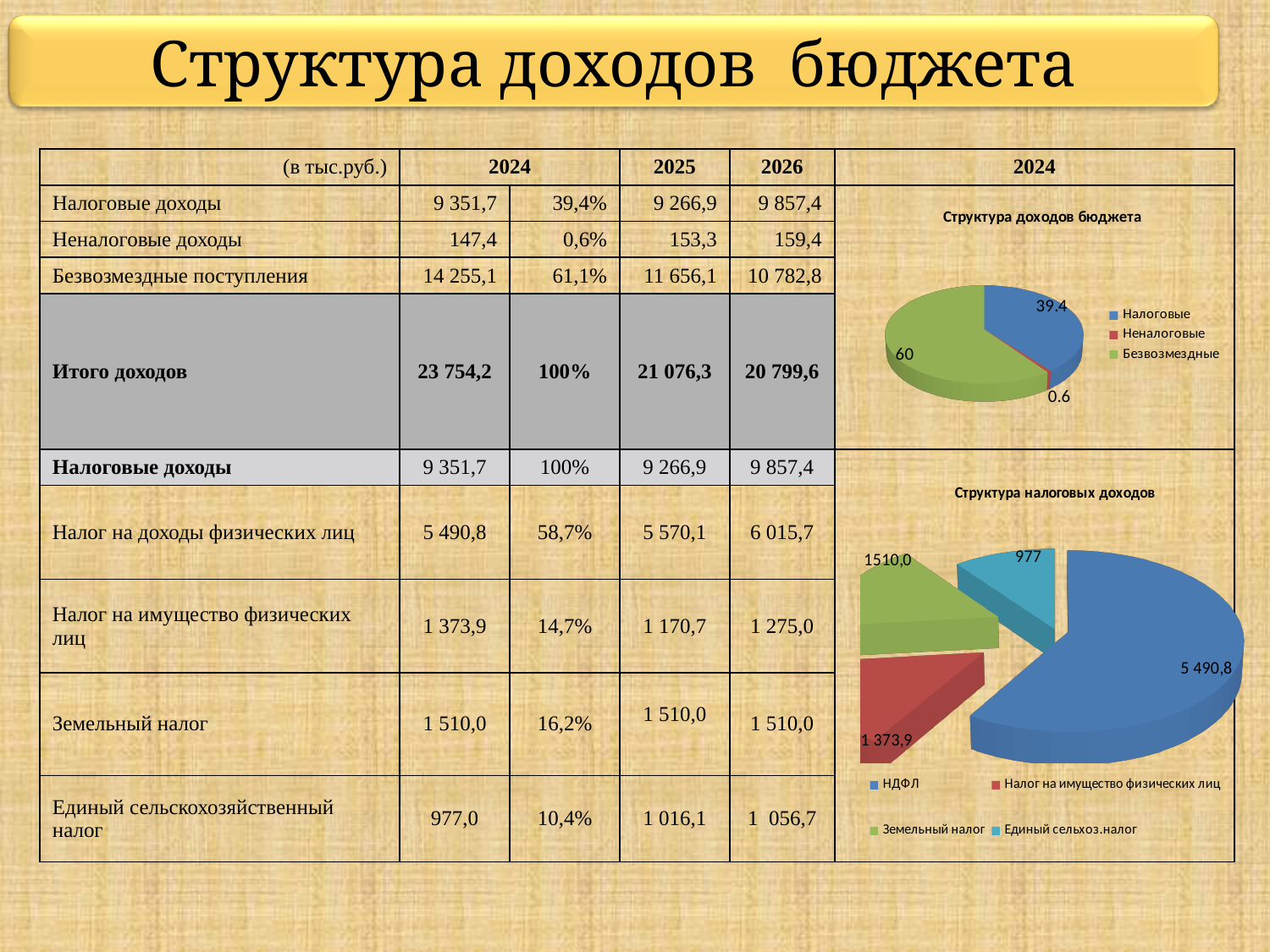
In the chart "Структура доходов бюджета", what value is shown for the Неналоговые slice? 0.6 How many categories does the legend of the chart "Структура налоговых доходов" list? 4 In the chart "Структура доходов бюджета", what value is shown for the Безвозмездные slice? 60 In the chart "Структура налоговых доходов", what value is shown for Единый сельхоз.налог? 977 In the chart "Структура доходов бюджета", which category has the largest slice? Безвозмездные In the chart "Структура доходов бюджета", what value is shown for the Налоговые slice? 39.4 In the chart "Структура налоговых доходов", which is larger: Земельный налог or Налог на имущество физических лиц? Земельный налог In the chart "Структура налоговых доходов", what value is shown for Налог на имущество физических лиц? 1 373,9 In the chart "Структура доходов бюджета", which category has the smallest slice? Неналоговые What type of chart is the chart titled "Структура доходов бюджета"? pie chart How many categories does the legend of the chart "Структура доходов бюджета" list? 3 In the chart "Структура налоговых доходов", what value is shown for НДФЛ? 5 490,8